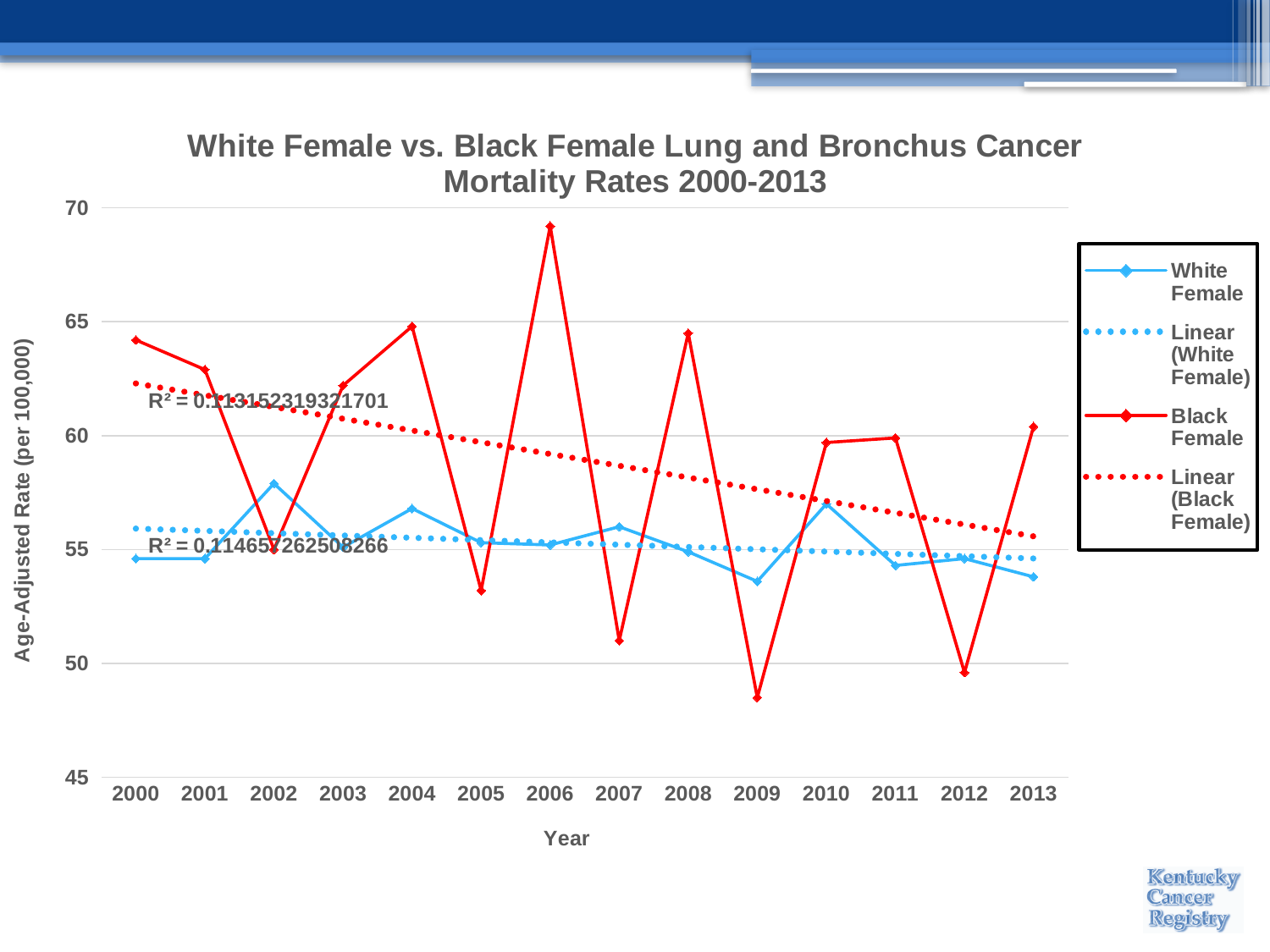
Is the Black Female value for 2006 greater or less than 65? greater How many entries does the legend list? 4 Is the White Female value for 2002 greater or less than 55? greater In which year is the Black Female mortality rate lowest? 2009 Does the Linear (Black Female) trendline rise or fall from 2000 to 2013? fall What kind of chart is shown on the slide? line chart How many years are plotted along the x axis? 14 In which year is the Black Female mortality rate highest? 2006 In 2009, which series has the larger value, White Female or Black Female? White Female Is the Black Female value for 2009 greater or less than 50? less What is the label on the y axis? Age-Adjusted Rate (per 100,000)